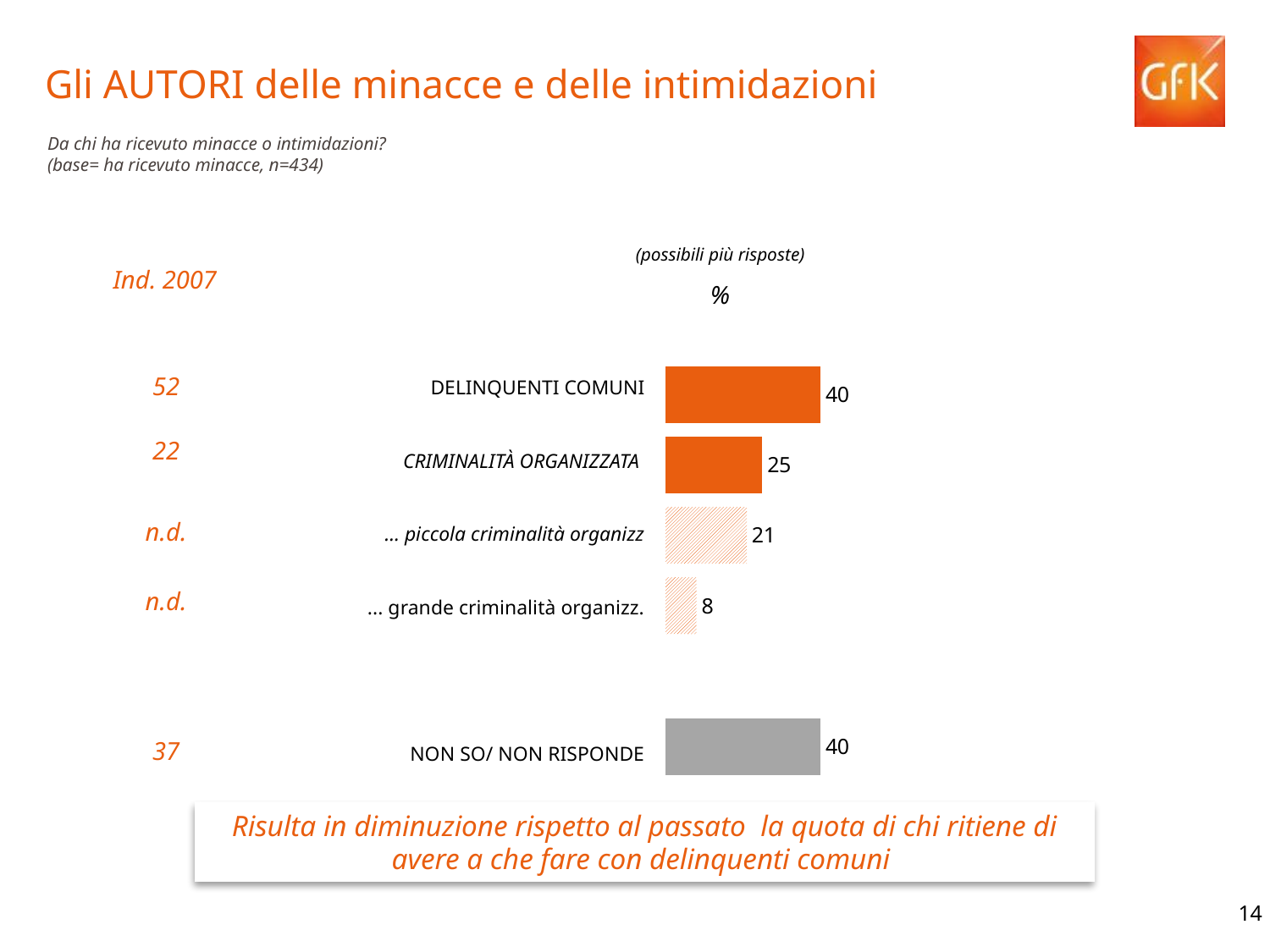
What is the difference between the values for DELINQUENTI COMUNI and CRIMINALITÀ ORGANIZZATA? 15 Which category has the lowest value in the chart? ... grande criminalità organizz. Which is larger, the value for CRIMINALITÀ ORGANIZZATA or the value for "... piccola criminalità organizz"? CRIMINALITÀ ORGANIZZATA What value is shown for "... grande criminalità organizz."? 8 What is the Ind. 2007 value shown next to DELINQUENTI COMUNI? 52 What is the difference between the values for "... piccola criminalità organizz" and "... grande criminalità organizz."? 13 What value is shown for CRIMINALITÀ ORGANIZZATA? 25 What value is shown for "... piccola criminalità organizz"? 21 How many bars are shown in the chart? 5 What value is shown for NON SO/ NON RISPONDE? 40 What kind of chart is shown on the slide? Bar chart What value is shown for DELINQUENTI COMUNI? 40